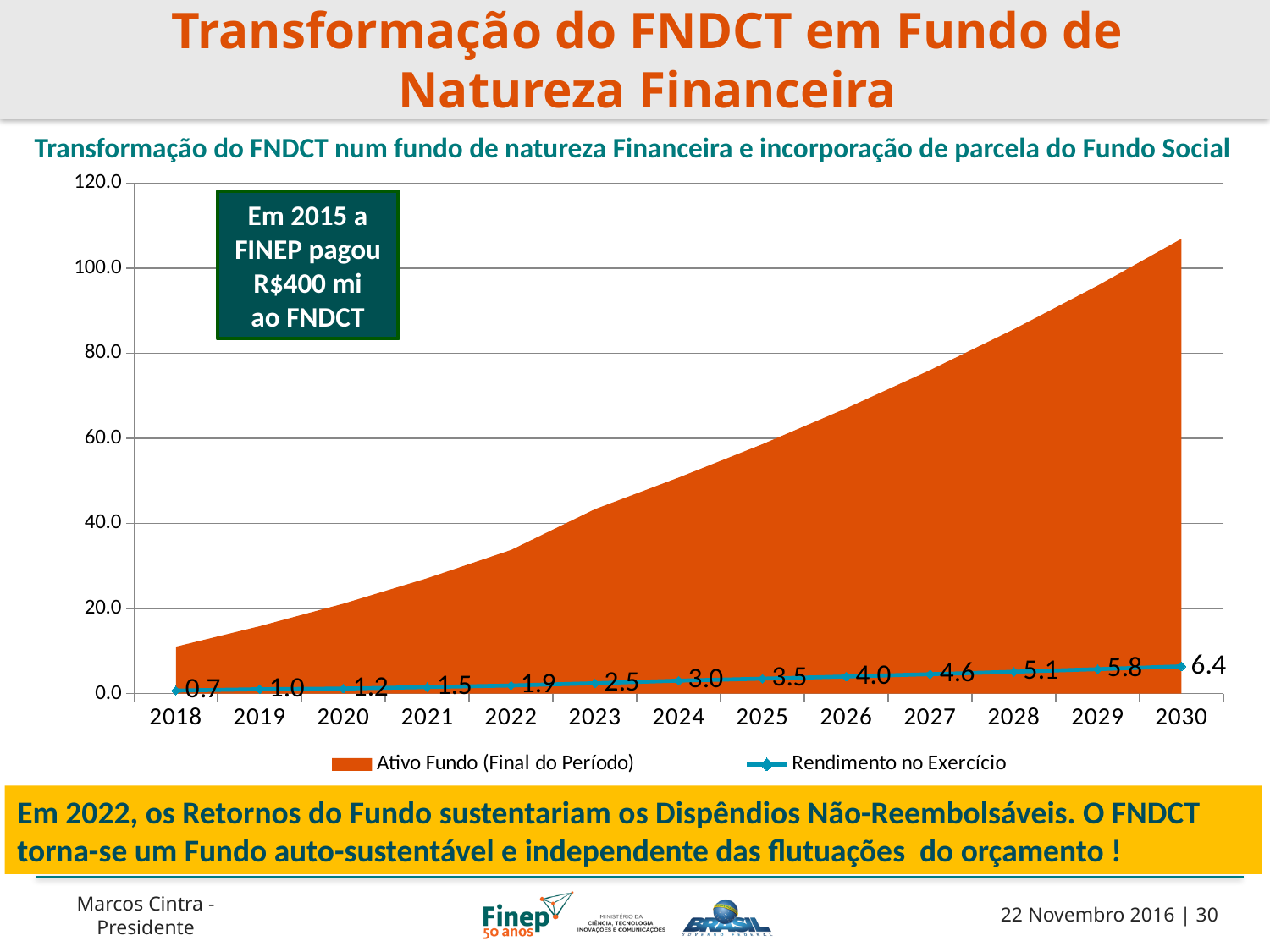
In which year is Rendimento no Exercício lowest? 2018 What is the value of Rendimento no Exercício in 2018? 0.7 Is the value of Ativo Fundo (Final do Período) in 2018 greater or less than 20.0? less What is the value of Rendimento no Exercício in 2024? 3.0 In which year is Rendimento no Exercício highest? 2030 How many series does the legend list? 2 Is the value of Ativo Fundo (Final do Período) in 2030 greater or less than 100.0? greater What is the difference between Rendimento no Exercício in 2030 and in 2018? 5.7 Which is larger, Rendimento no Exercício in 2027 or in 2025? 2027 What is the value of Rendimento no Exercício in 2030? 6.4 How many years are shown on the x axis? 13 Does Rendimento no Exercício rise or fall from 2018 to 2030? rise